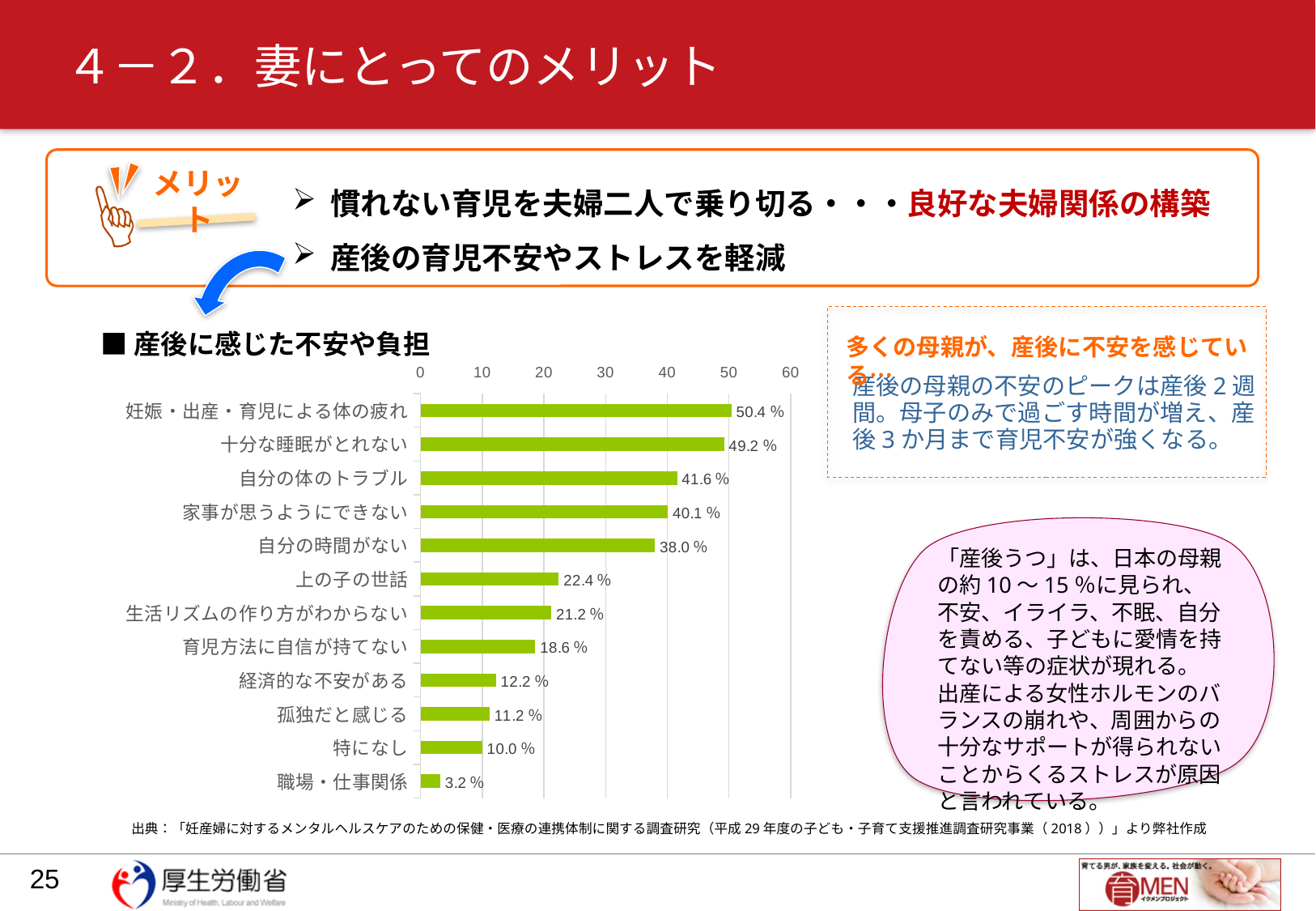
What is the difference between the values for 十分な睡眠がとれない and 自分の体のトラブル? 7.6 % Which is larger, the value for 上の子の世話 or the value for 育児方法に自信が持てない? 上の子の世話 What is the maximum value shown on the chart's horizontal axis? 60 Which category has the lowest value in the chart? 職場・仕事関係 What is the difference between the values for 経済的な不安がある and 特になし? 2.2 % Is the value for 家事が思うようにできない greater or less than 30? greater What kind of chart is shown under the heading 産後に感じた不安や負担? bar chart What is the value for 妊娠・出産・育児による体の疲れ? 50.4 % How many categories are plotted in the 産後に感じた不安や負担 chart? 12 Which category has the highest value in the chart? 妊娠・出産・育児による体の疲れ What is the value for 自分の時間がない? 38.0 % What is the value for 孤独だと感じる? 11.2 %